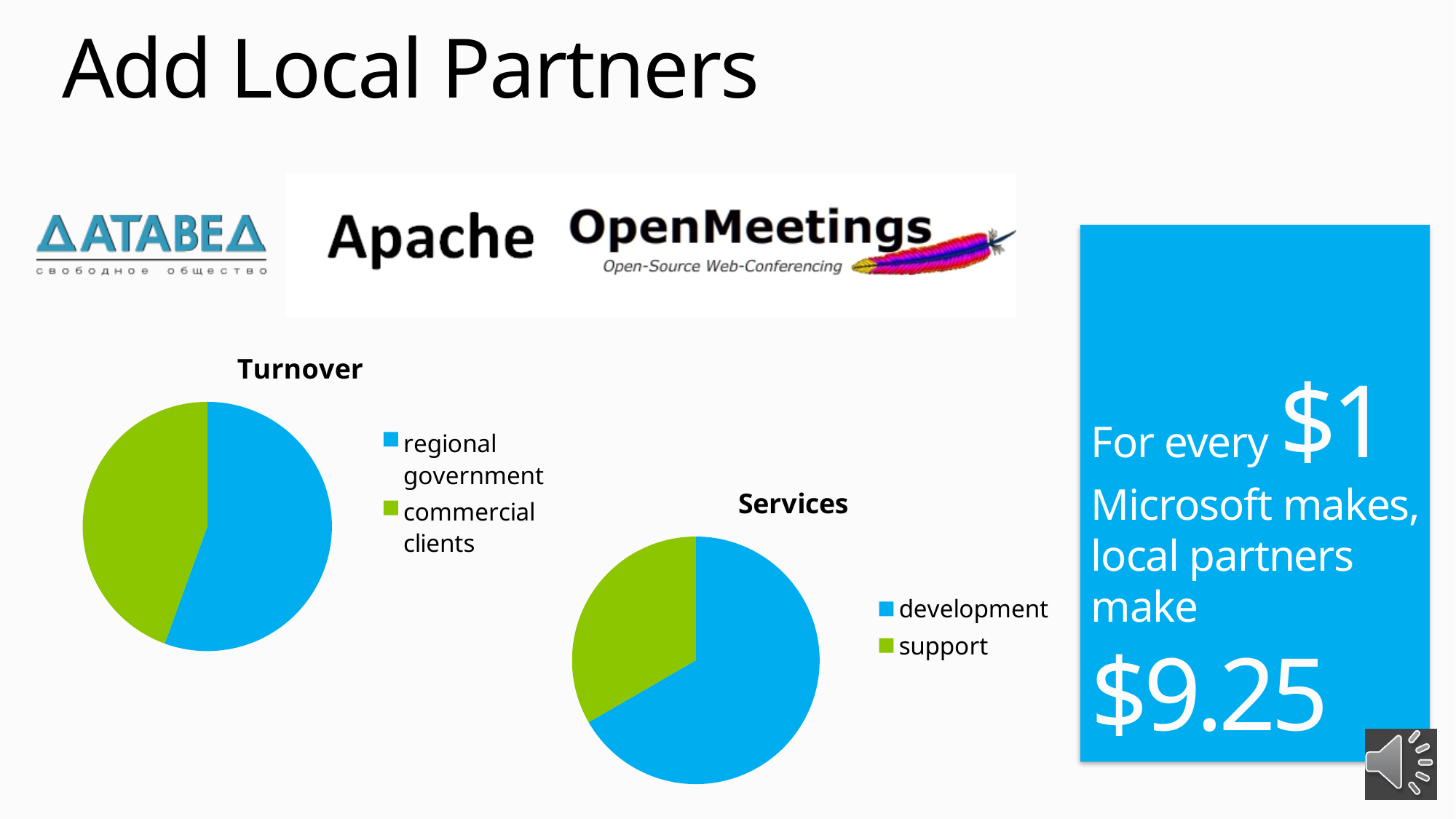
How many entries does the legend of the Services chart list? 2 How many slices does the Turnover pie chart have? 2 What kind of chart is the Turnover chart? pie chart In the Turnover chart, which slice is larger, regional government or commercial clients? regional government In the Services chart, which slice is larger, development or support? development In the Services chart, which category has the smallest slice? support What kind of chart is the Services chart? pie chart What are the two categories shown in the legend of the Turnover chart? regional government, commercial clients In the Services chart, which category has the largest slice? development How many slices does the Services pie chart have? 2 In the Services chart, what colour represents support? green